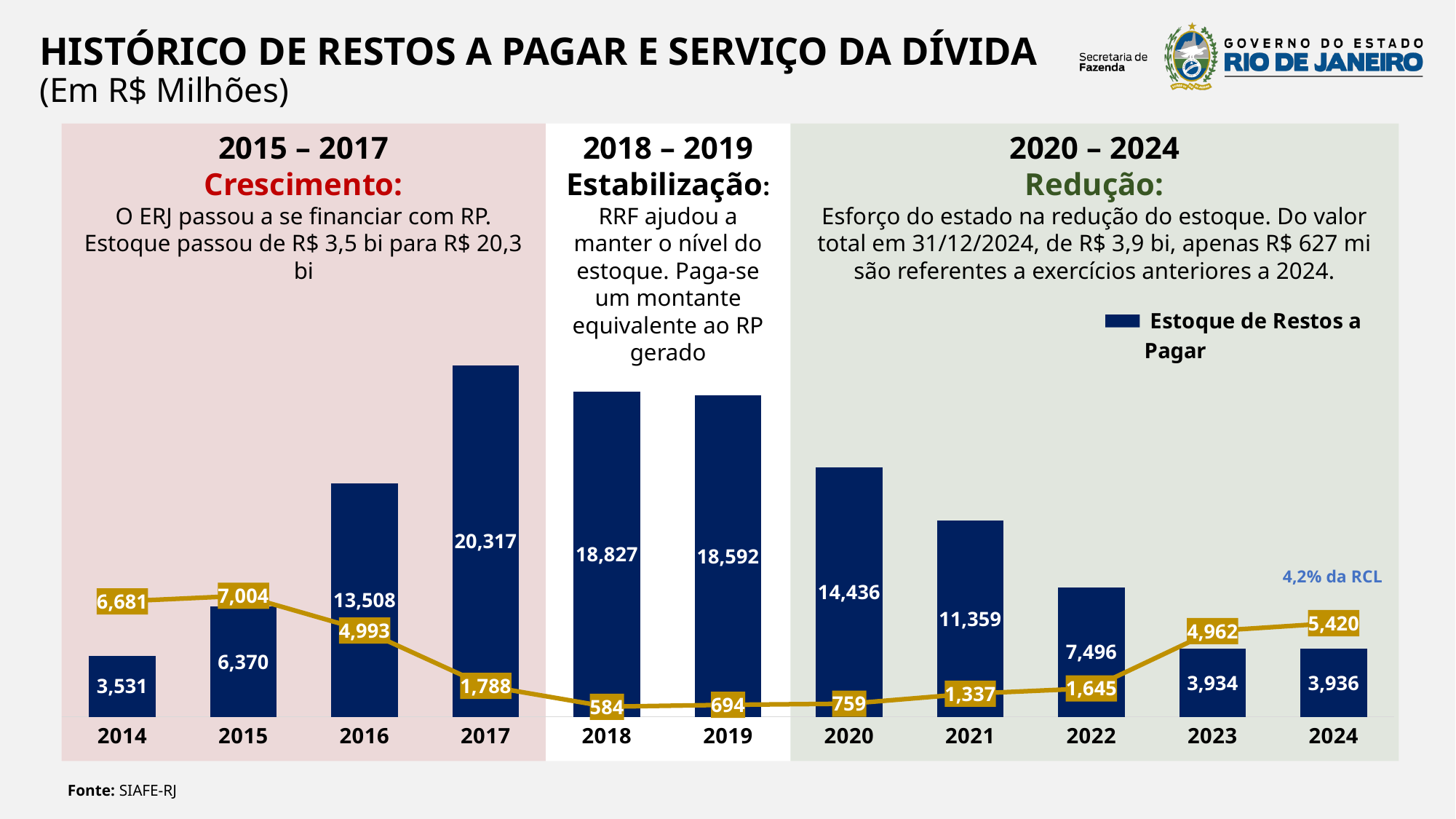
Do the Estoque de Restos a Pagar bars rise or fall from 2017 to 2024? Fall What is the value of Estoque de Restos a Pagar for 2020? 14,436 Which year has the lowest Estoque de Restos a Pagar? 2014 How many series does the chart legend list? 1 Which year has the highest Estoque de Restos a Pagar? 2017 How many years are shown on the x axis of the chart? 11 Which year has a larger Estoque de Restos a Pagar, 2018 or 2019? 2018 What is the value labelled on the gold line at 2024? 5,420 What is the value of Estoque de Restos a Pagar for 2017? 20,317 What is the difference between the Estoque de Restos a Pagar in 2022 and in 2023? 3,562 What is the difference between the Estoque de Restos a Pagar in 2017 and in 2014? 16,786 What kind of chart is shown on the slide? Bar chart with a line